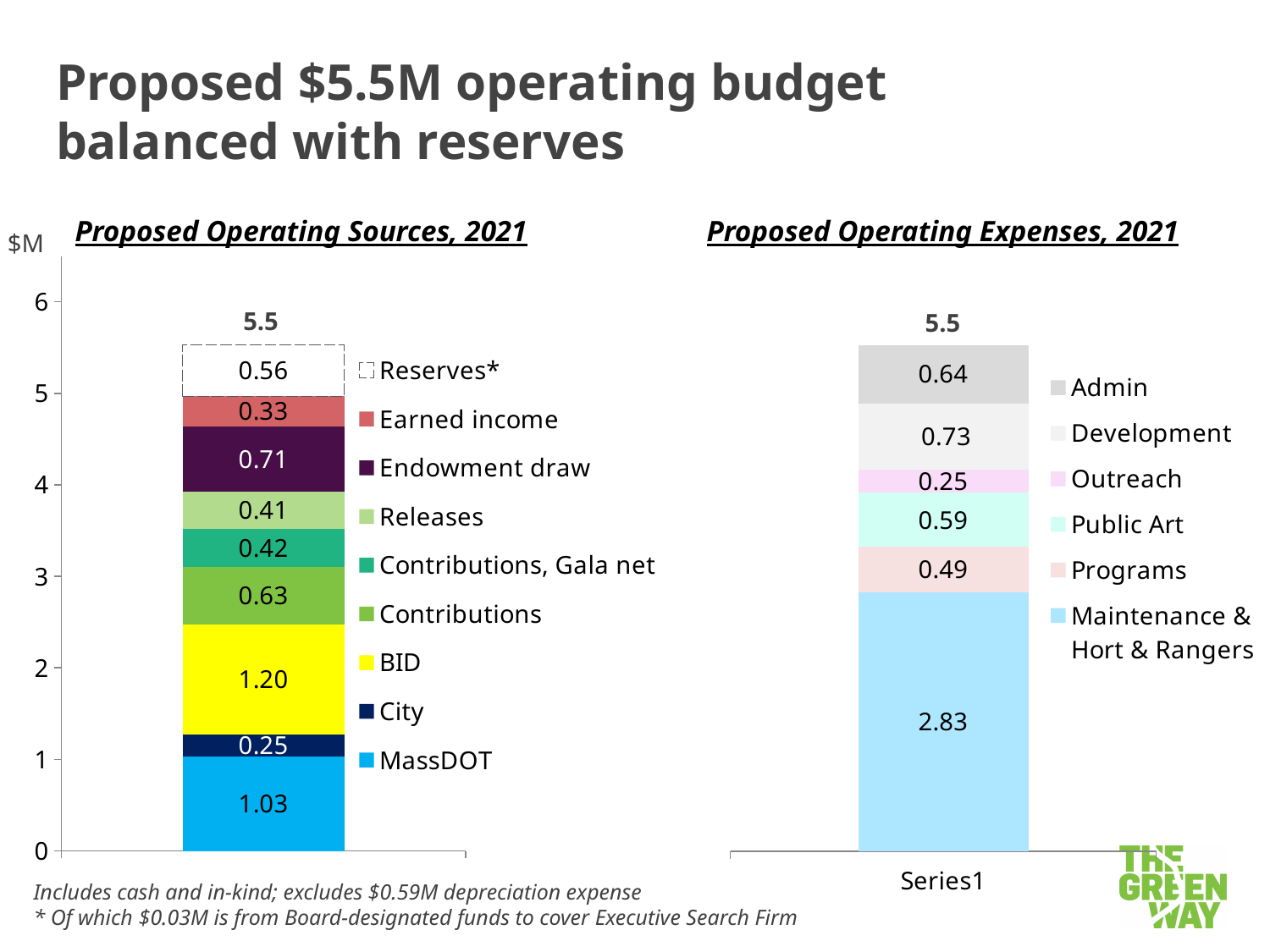
In the Proposed Operating Sources, 2021 chart, what is the difference between the MassDOT value and the City value? 0.78 In the Proposed Operating Sources, 2021 chart, what is the value for BID? 1.20 How many series does the legend of the Proposed Operating Sources, 2021 chart list? 9 In the Proposed Operating Expenses, 2021 chart, what is the value for Outreach? 0.25 What is the total of the stacked bar in the Proposed Operating Expenses, 2021 chart? 5.5 In the Proposed Operating Expenses, 2021 chart, what is the value for Maintenance & Hort & Rangers? 2.83 In the Proposed Operating Sources, 2021 chart, which source has the largest value? BID In the Proposed Operating Sources, 2021 chart, what is the value for Endowment draw? 0.71 How many series does the legend of the Proposed Operating Expenses, 2021 chart list? 6 In the Proposed Operating Expenses, 2021 chart, which is larger, Development or Admin? Development What kind of chart is the Proposed Operating Sources, 2021 chart? Stacked bar chart In the Proposed Operating Expenses, 2021 chart, which expense category has the smallest value? Outreach